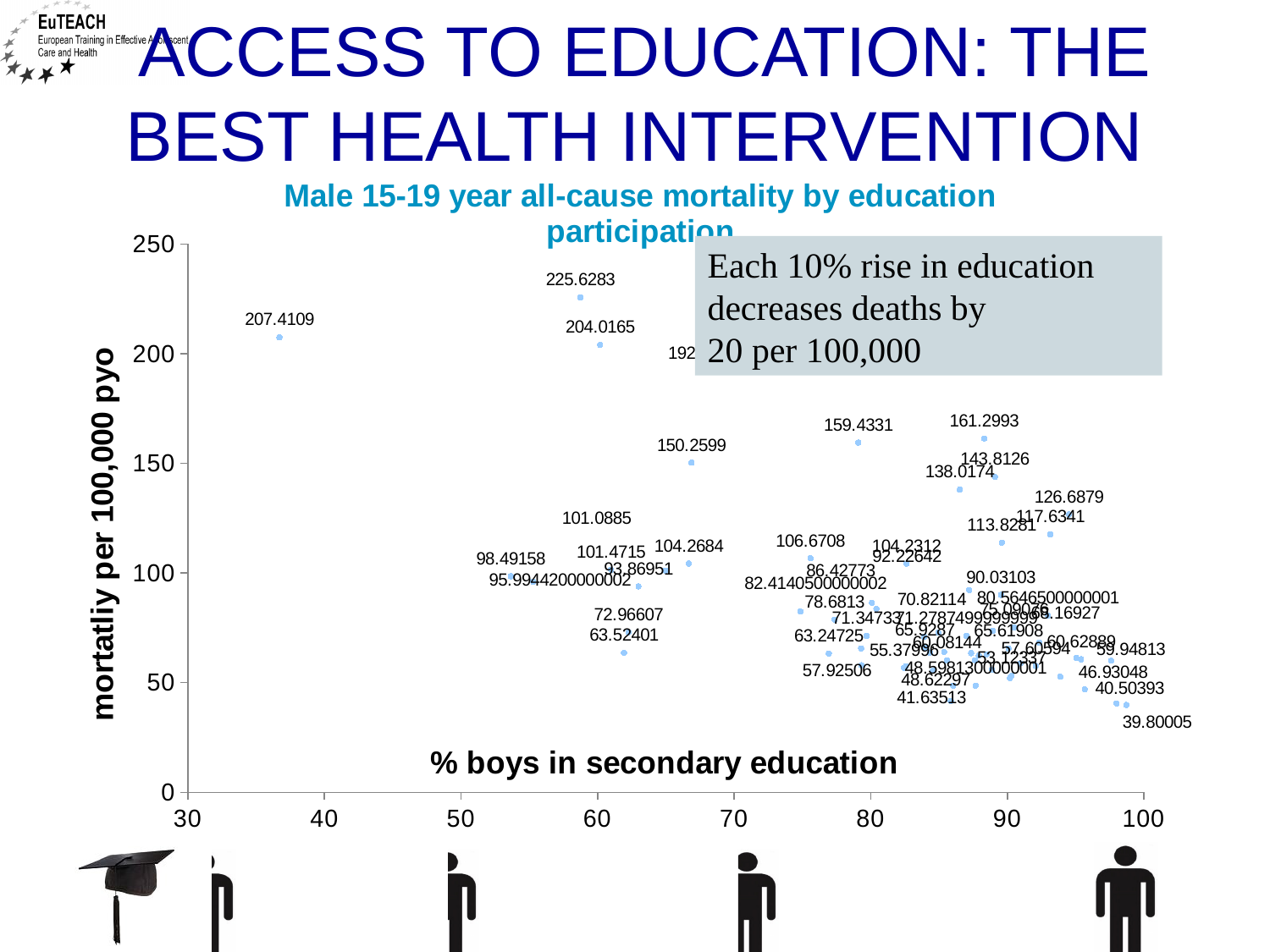
What is the difference between the highest labeled value (225.6283) and the lowest labeled value (39.80005)? 185.82825 What is the labeled mortality value of the rightmost point on the chart (near 100% participation)? 39.80005 Which is larger, the point labeled 207.4109 or the point labeled 204.0165? 207.4109 Is the mortality value for the point near 100% participation greater or less than 50? less What is the labeled mortality value of the leftmost point on the chart (at roughly 37% participation)? 207.4109 What is the title of the x axis? % boys in secondary education What is the highest mortality value labeled on the chart? 225.6283 Is the mortality value for the leftmost point (around 37% participation) greater or less than 200? greater What is the title of the chart? Male 15-19 year all-cause mortality by education participation What kind of chart is shown on the slide? scatter chart What is the lowest mortality value labeled on the chart? 39.80005 As the percentage of boys in secondary education increases along the x axis, does mortality generally rise or fall? fall